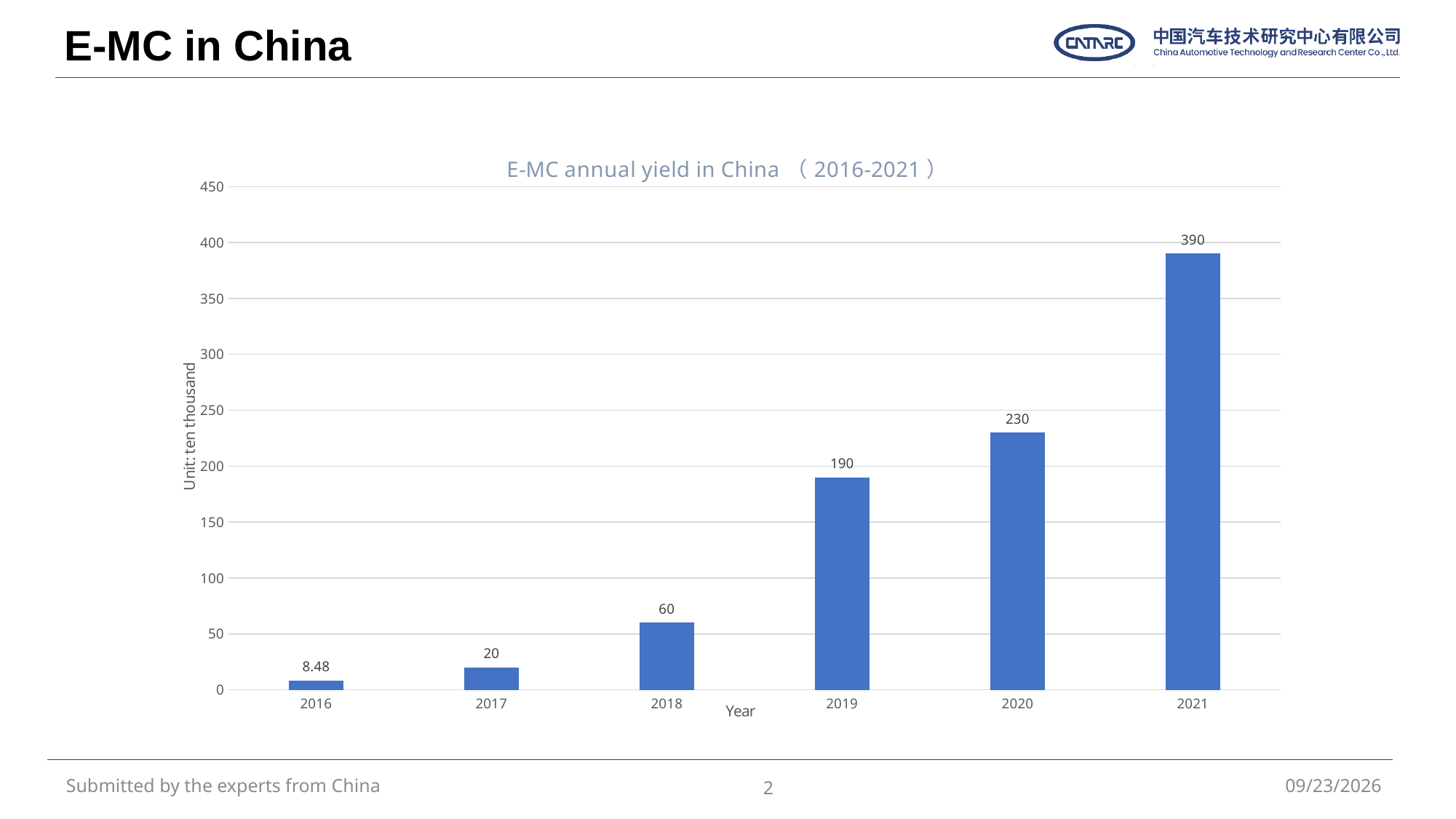
What is the E-MC annual yield in China for 2019? 190 What is the E-MC annual yield in China for 2021? 390 Which year has the lowest E-MC annual yield? 2016 What is the E-MC annual yield in China for 2016? 8.48 What is the difference between the E-MC annual yield in 2018 and in 2017? 40 Does the E-MC annual yield rise or fall from 2016 to 2021? Rise Which year has the highest E-MC annual yield? 2021 How many years are shown on the x axis of the chart? 6 Which year has a larger E-MC annual yield, 2019 or 2020? 2020 What kind of chart is shown on the slide? Bar chart Is the E-MC annual yield for 2020 greater or less than 200? greater What is the difference between the E-MC annual yield in 2021 and in 2020? 160